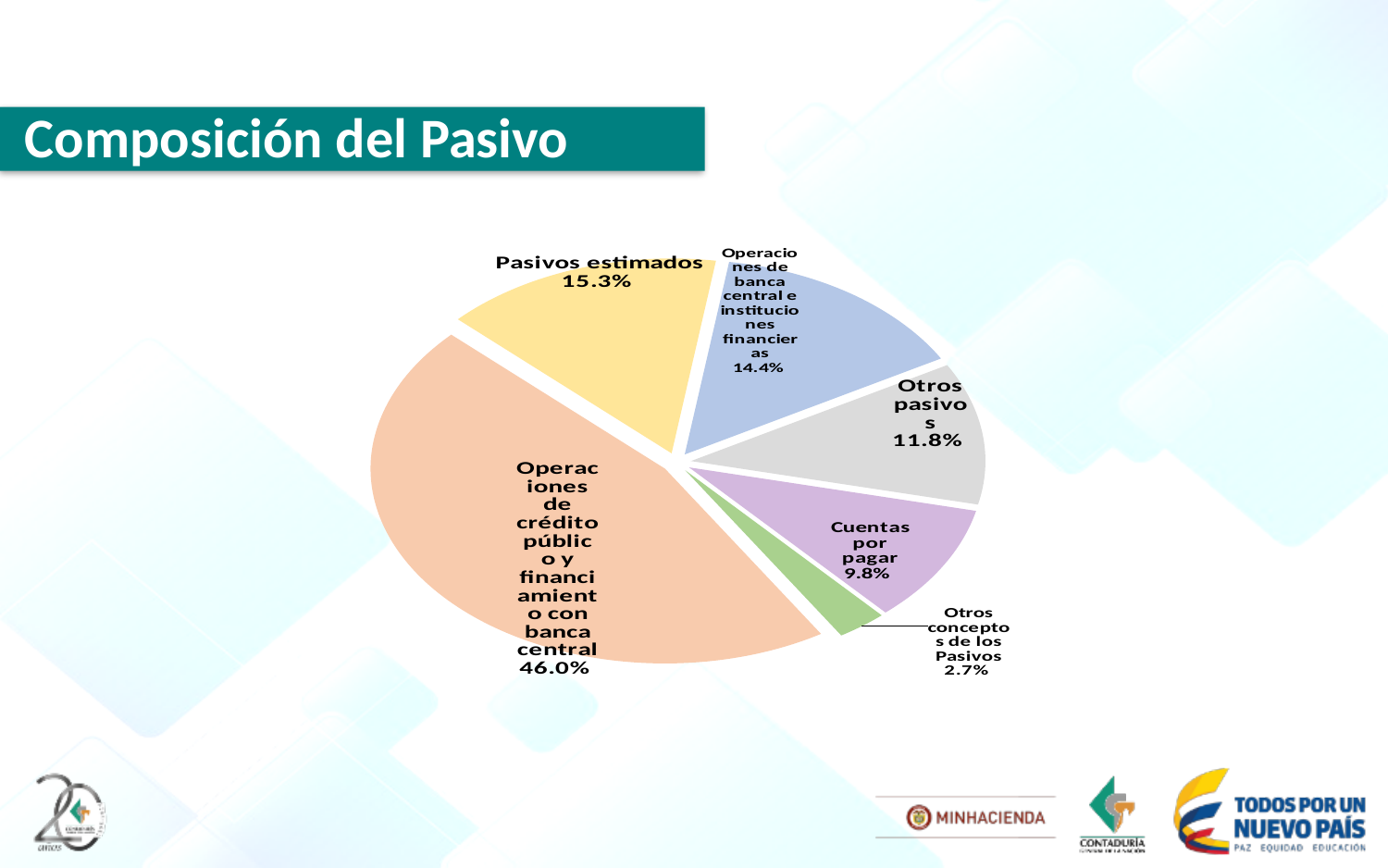
What percentage is shown for Otros pasivos? 11.8% What share of the pie is Pasivos estimados? 15.3% What percentage is shown for Operaciones de banca central e instituciones financieras? 14.4% How many slices does the pie chart have? 6 What is the combined share of Otros pasivos and Otros conceptos de los Pasivos? 14.5% What percentage is shown for Cuentas por pagar? 9.8% Which category has the smallest share of the pie? Otros conceptos de los Pasivos What kind of chart is shown on the slide? Pie chart What is the difference in percentage points between Pasivos estimados and Cuentas por pagar? 5.5 Which is larger, the share for Otros pasivos or the share for Cuentas por pagar? Otros pasivos What is the title of the slide? Composición del Pasivo Which category has the largest share of the pie? Operaciones de crédito público y financiamiento con banca central